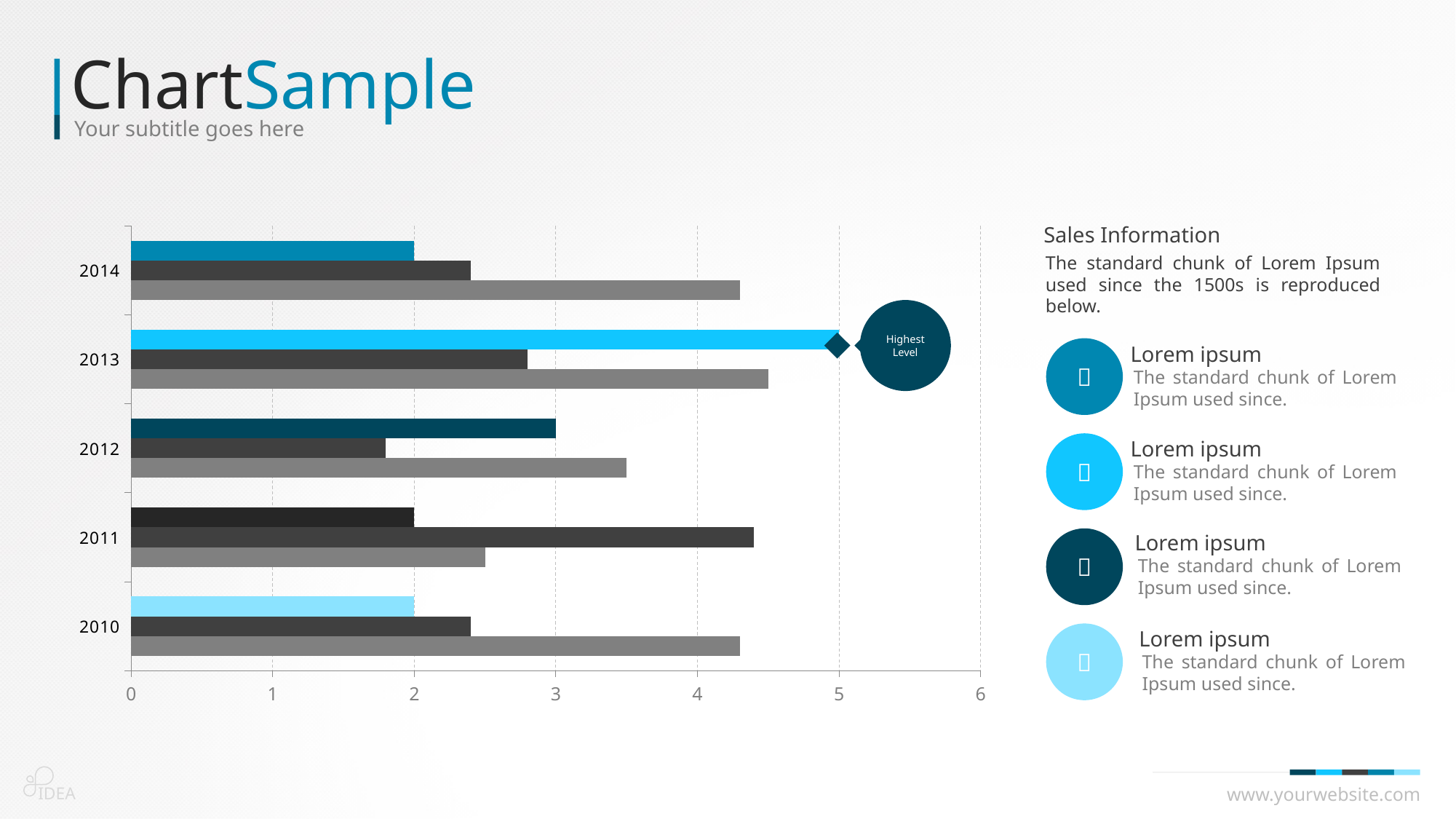
Is the value of the middle (dark gray) bar for 2012 greater or less than 2? less Which is larger: the top bar for 2013 or the top bar for 2012? 2013 Which year has the longest bar in the chart? 2013 What is the difference between the top bar for 2013 and the top bar for 2014? 3 Is the value of the bottom (light gray) bar for 2013 greater or less than 4? greater What kind of chart is shown on the slide? bar chart What is the value of the top (dark blue) bar for 2012? 3 What is the value of the top (blue) bar for 2014? 2 Is the value of the middle (dark gray) bar for 2011 greater or less than 4? greater How many year categories are shown on the chart's vertical axis? 5 What label is shown in the circle callout pointing to the 2013 bar? Highest Level What is the value of the top (bright blue) bar for 2013? 5